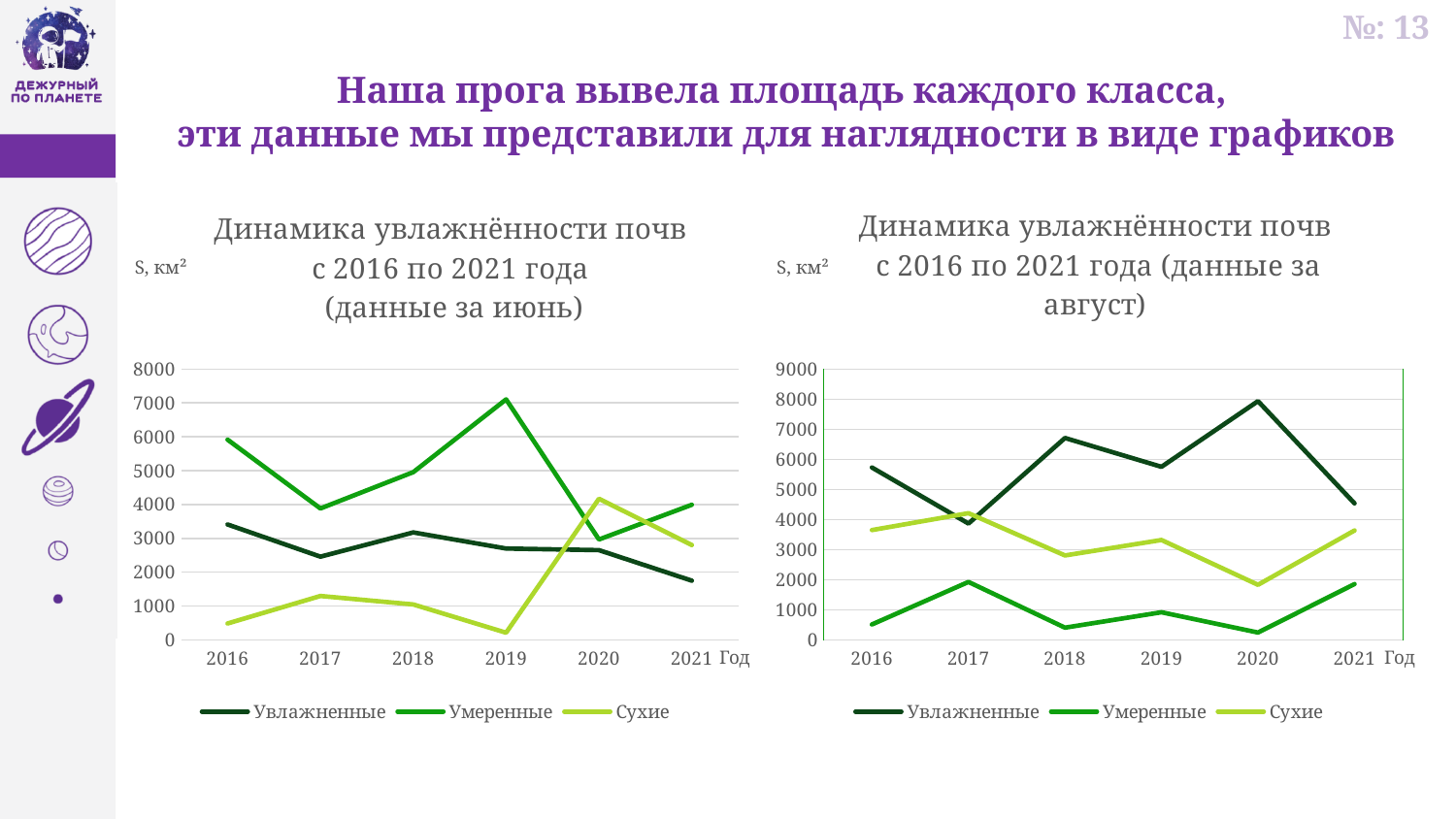
In the left chart (данные за июнь), is the value for Сухие in 2016 greater or less than 1000? less In the right chart (данные за август), does the Умеренные series rise or fall from 2020 to 2021? rise In the left chart (данные за июнь), is the value for Умеренные in 2019 greater or less than 7000? greater In the left chart (данные за июнь), in which year does the Умеренные series reach its highest value? 2019 What is the y-axis unit label shown on the left chart (данные за июнь)? S, км² How many series does the legend of the right chart (данные за август) list? 3 How many years are shown on the x axis of the left chart (данные за июнь)? 6 In the right chart (данные за август), which is larger in 2018: Увлажненные or Сухие? Увлажненные In the right chart (данные за август), is the value for Увлажненные in 2020 greater or less than 7000? greater In the left chart (данные за июнь), in which year is the Сухие series lowest? 2019 What kind of chart is the left chart (данные за июнь)? line chart In the right chart (данные за август), in which year does the Увлажненные series reach its highest value? 2020